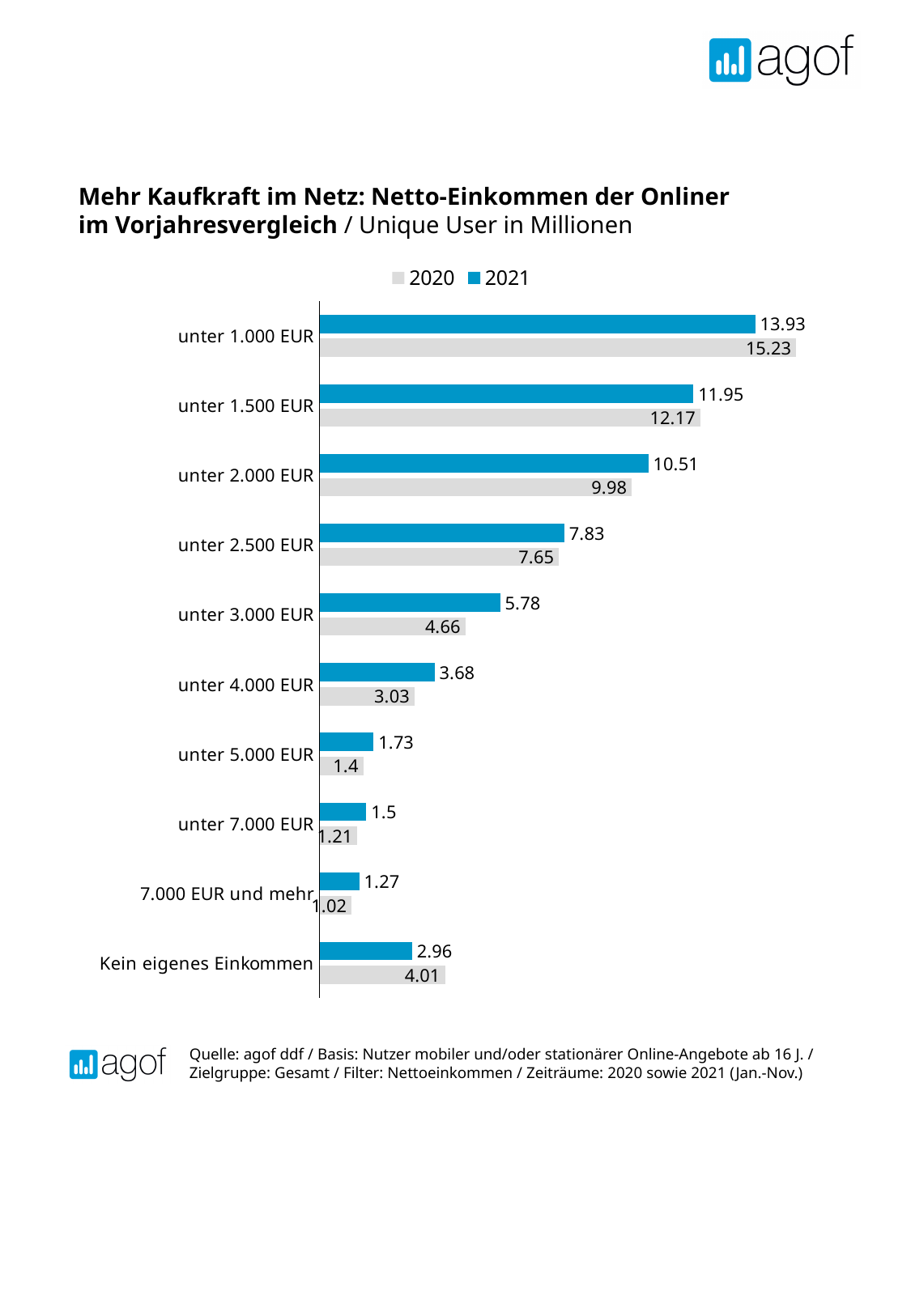
How many series does the legend list? 2 What is the 2020 value for "unter 5.000 EUR"? 1.4 For "unter 1.500 EUR", which year has the larger value, 2020 or 2021? 2020 For "unter 4.000 EUR", which year has the larger value, 2020 or 2021? 2021 How many income categories are shown on the chart? 10 What is the difference between the 2021 and 2020 values for "unter 3.000 EUR"? 1.12 What kind of chart is shown on the slide? Bar chart Which category has the highest 2021 value? unter 1.000 EUR Which category has the lowest 2020 value? 7.000 EUR und mehr What is the 2021 value for "unter 2.000 EUR"? 10.51 What is the difference between the 2020 and 2021 values for "unter 1.000 EUR"? 1.3 What is the 2020 value for "Kein eigenes Einkommen"? 4.01